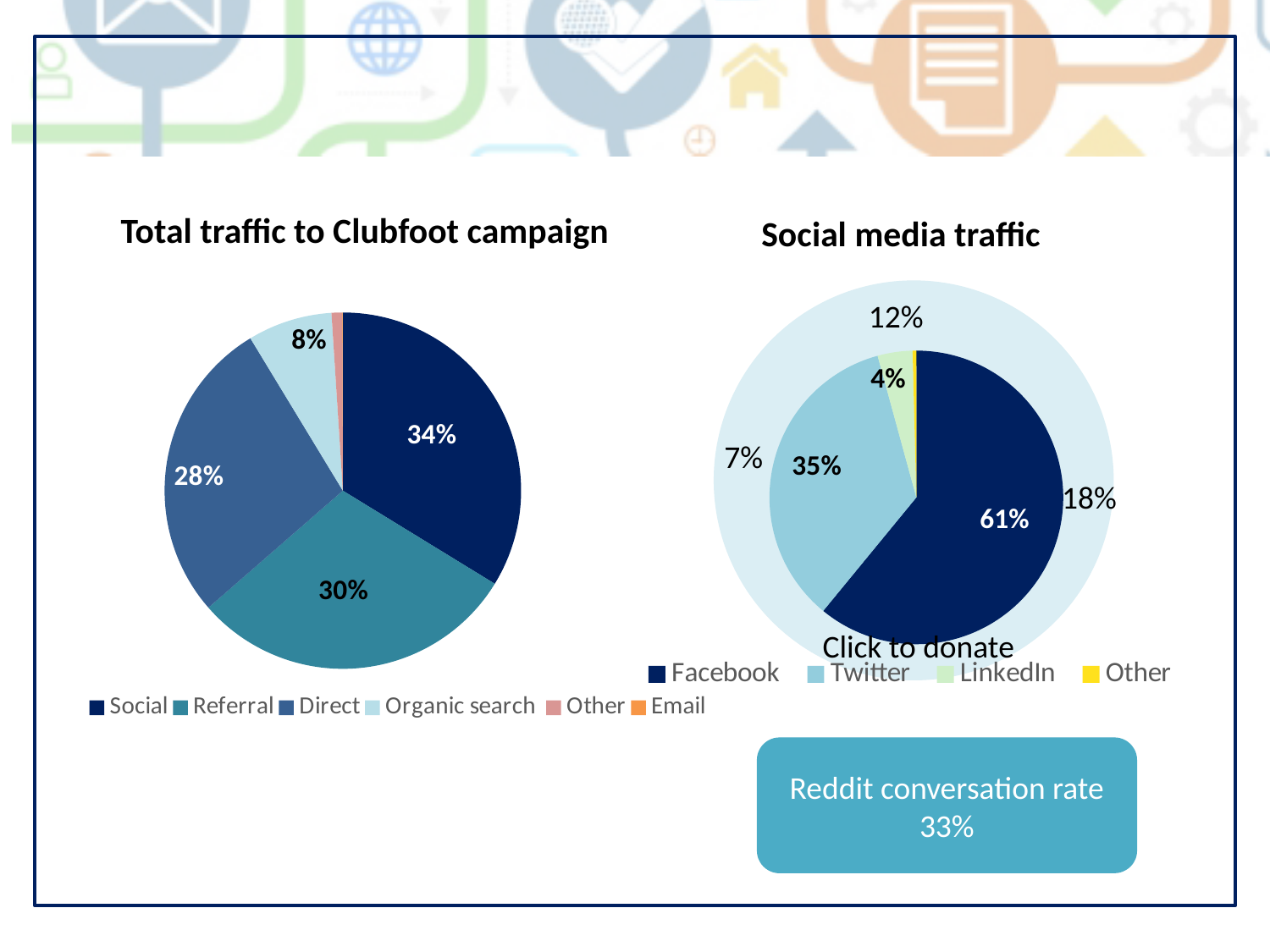
In the 'Social media traffic' chart, which platform has the largest share? Facebook In the 'Total traffic to Clubfoot campaign' chart, what share of traffic is Referral? 30% In the 'Social media traffic' chart, what share of traffic is LinkedIn? 4% In the 'Total traffic to Clubfoot campaign' chart, which source has the largest share? Social What kind of chart is 'Total traffic to Clubfoot campaign'? Pie chart In the 'Total traffic to Clubfoot campaign' chart, what share of traffic is Organic search? 8% In the 'Social media traffic' chart, what is the difference between the Facebook and Twitter shares? 26% In the 'Social media traffic' chart, what share of traffic is Facebook? 61% In the 'Total traffic to Clubfoot campaign' chart, what is the difference between the Social and Direct shares? 6% In the 'Social media traffic' chart, what share of traffic is Twitter? 35% In the 'Total traffic to Clubfoot campaign' chart, what share of traffic is Social? 34% In the 'Total traffic to Clubfoot campaign' chart, how many sources does the legend list? 6